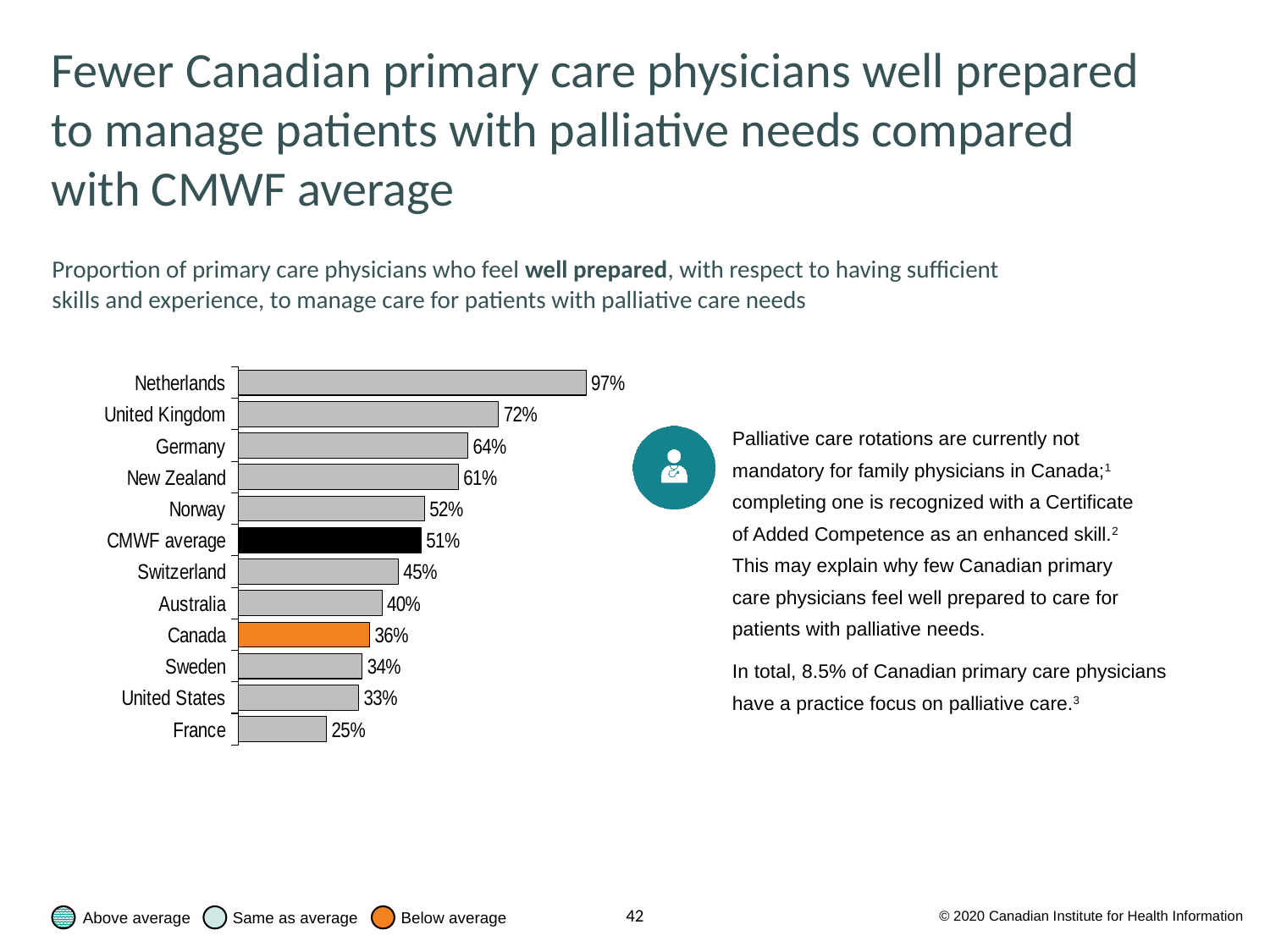
What is the difference between the Netherlands and the United Kingdom? 25% What is the value for Canada? 36% Which has a higher value, Germany or New Zealand? Germany What is the difference between the CMWF average and Canada's value? 15% What is the value for the Netherlands? 97% What is the CMWF average value? 51% Which has a higher value, Sweden or the United States? Sweden What type of chart is shown on the slide? Bar chart Which country has the highest proportion of primary care physicians who feel well prepared? Netherlands Which country has the lowest proportion of primary care physicians who feel well prepared? France Which bar is coloured orange in the chart? Canada How many bars are shown in the chart, including the CMWF average? 12